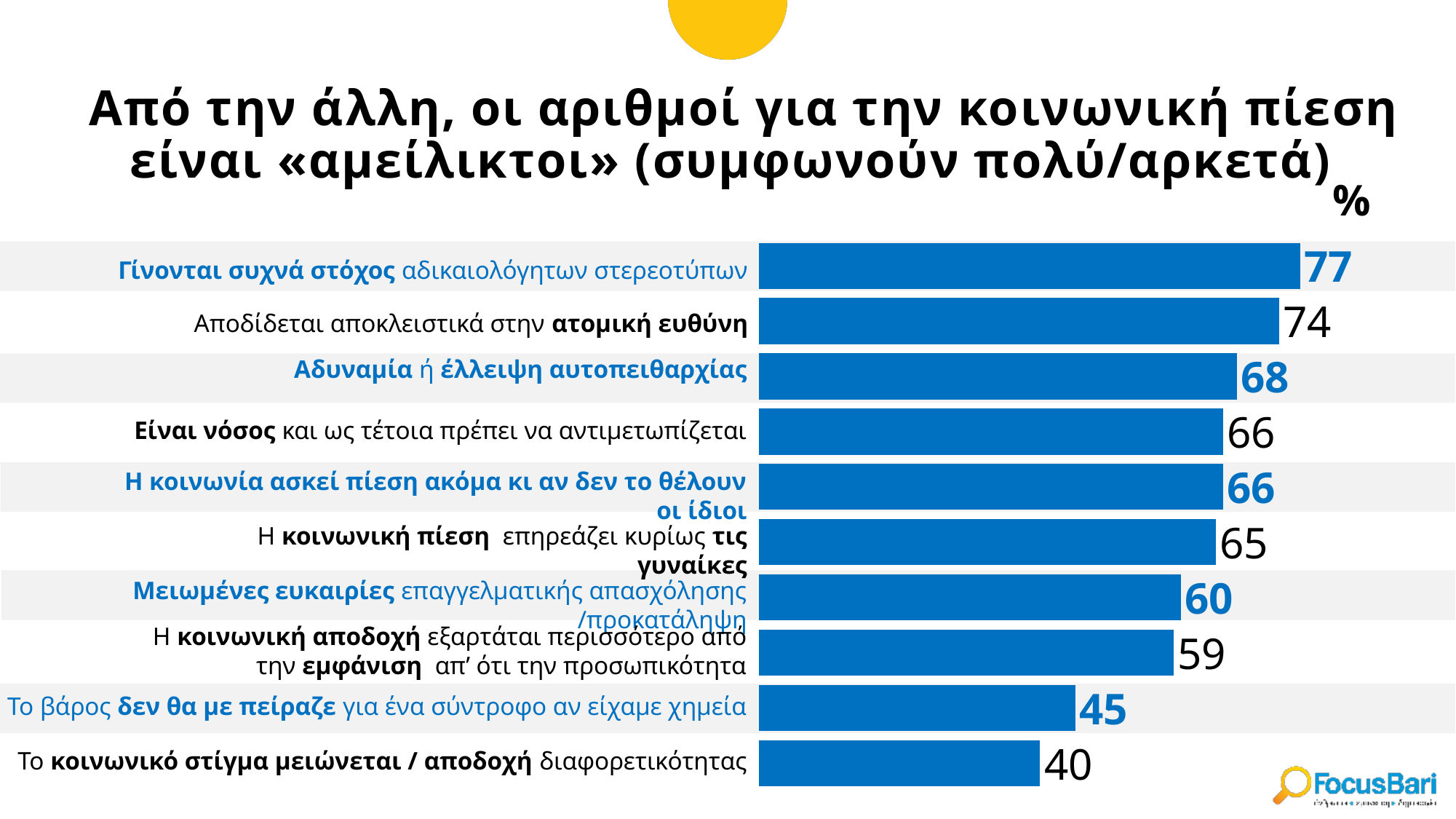
Which statement has the lowest value on the chart? Το κοινωνικό στίγμα μειώνεται / αποδοχή διαφορετικότητας What value is shown for «Αποδίδεται αποκλειστικά στην ατομική ευθύνη»? 74 Which has a larger value: «Η κοινωνική πίεση επηρεάζει κυρίως τις γυναίκες» or «Η κοινωνική αποδοχή εξαρτάται περισσότερο από την εμφάνιση απ' ότι την προσωπικότητα»? Η κοινωνική πίεση επηρεάζει κυρίως τις γυναίκες What value is shown for «Είναι νόσος και ως τέτοια πρέπει να αντιμετωπίζεται»? 66 How many statements (bars) are shown on the chart? 10 What type of chart is shown on the slide? Bar chart What unit symbol is shown at the top right of the chart? % What is the difference between the values for «Αδυναμία ή έλλειψη αυτοπειθαρχίας» and «Μειωμένες ευκαιρίες επαγγελματικής απασχόλησης/προκατάληψη»? 8 What value is shown for «Το βάρος δεν θα με πείραζε για ένα σύντροφο αν είχαμε χημεία»? 45 What value is shown for «Γίνονται συχνά στόχος αδικαιολόγητων στερεοτύπων»? 77 What is the difference between the values for «Γίνονται συχνά στόχος αδικαιολόγητων στερεοτύπων» and «Το κοινωνικό στίγμα μειώνεται / αποδοχή διαφορετικότητας»? 37 Which statement has the highest value on the chart? Γίνονται συχνά στόχος αδικαιολόγητων στερεοτύπων